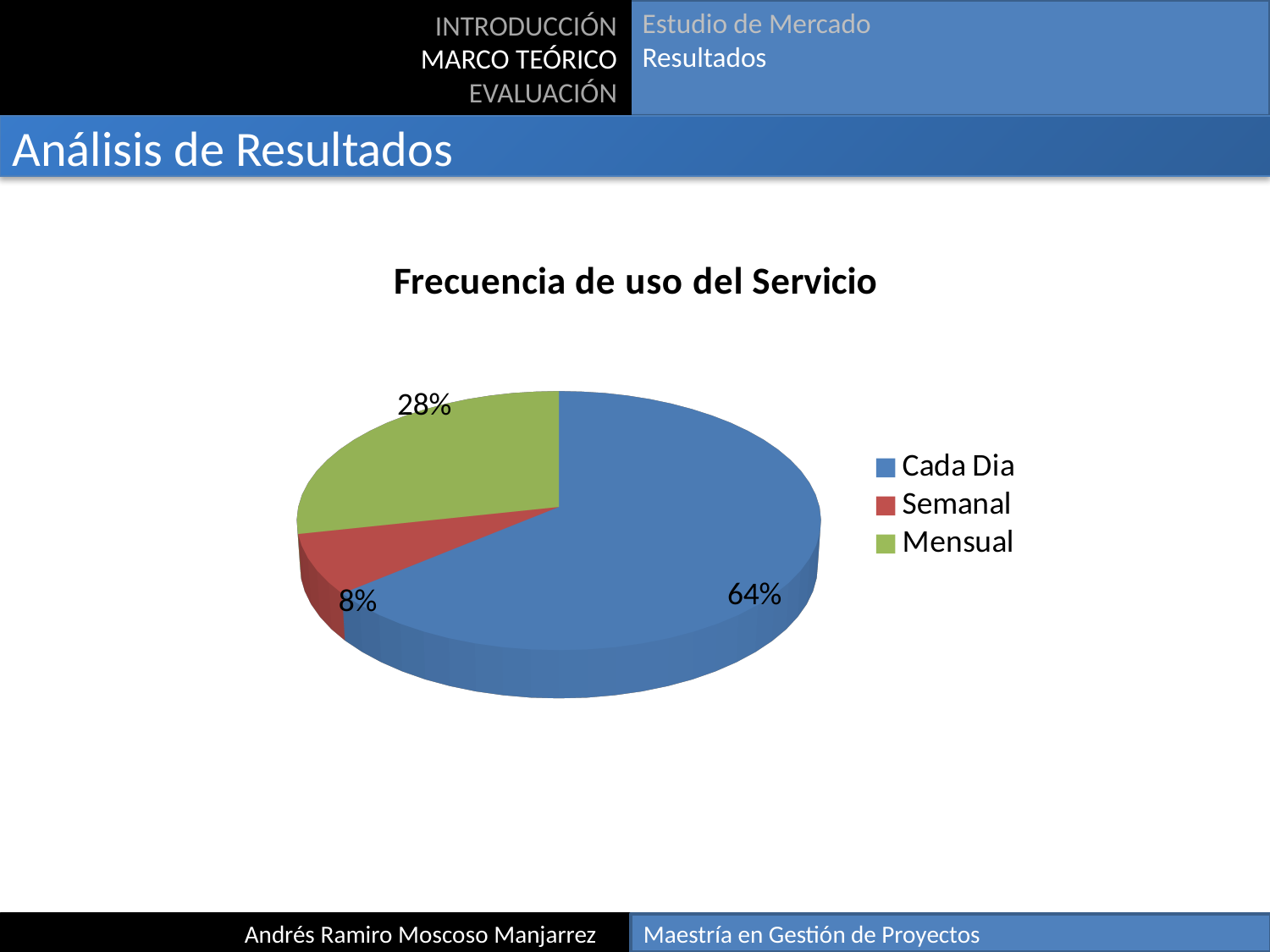
What share of the pie does Cada Dia represent? 64% Which category has the smallest slice of the pie? Semanal Which category has the largest slice of the pie? Cada Dia What is the title of the chart? Frecuencia de uso del Servicio Which is larger, the share for Mensual or the share for Semanal? Mensual What share of the pie does Semanal represent? 8% What is the difference in percentage points between Cada Dia and Mensual? 36 What share of the pie does Mensual represent? 28% What colour is the Semanal slice in the pie chart? red How many categories does the pie chart show? 3 What kind of chart is shown on the slide? pie chart What is the difference in percentage points between Mensual and Semanal? 20